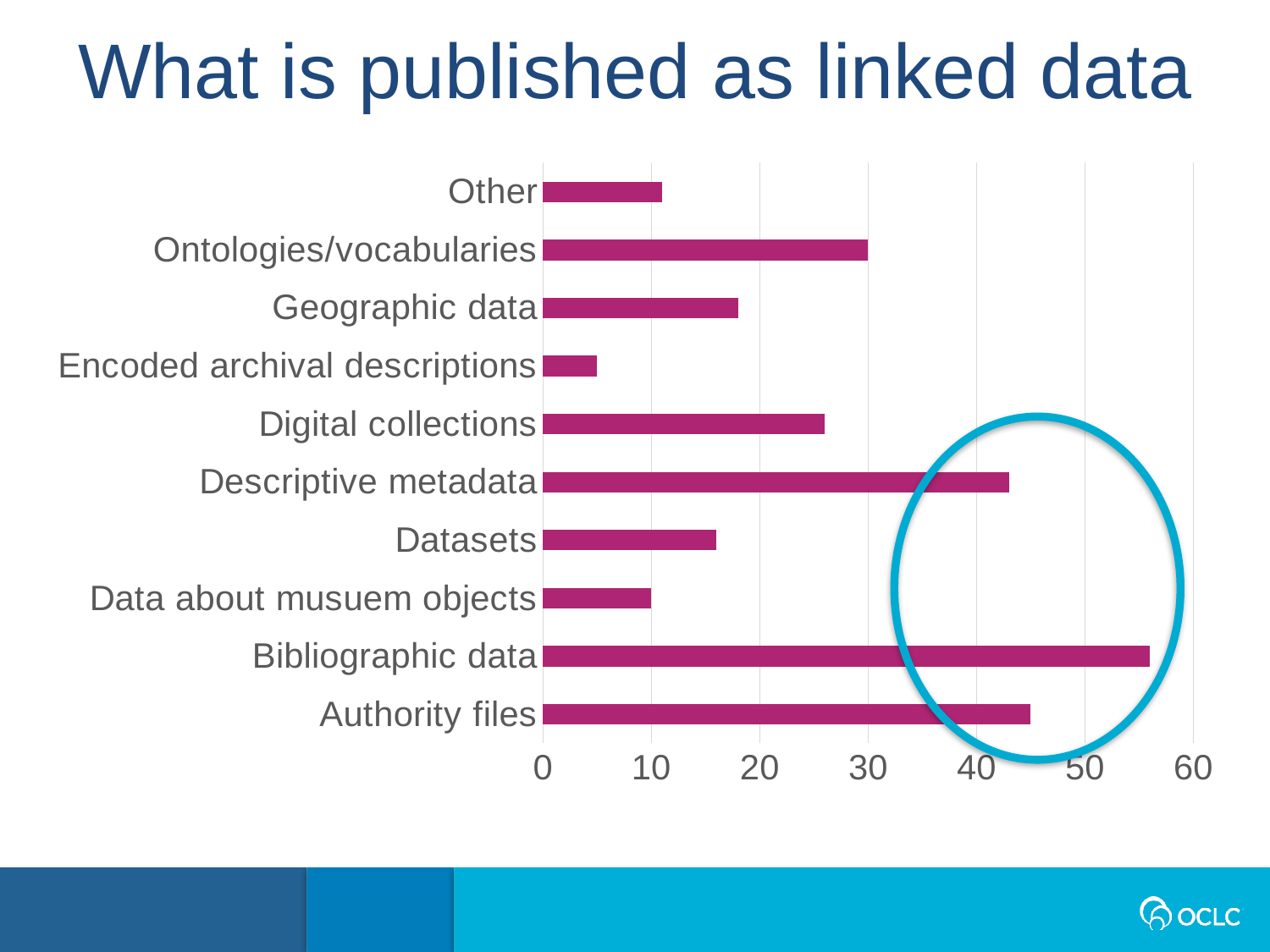
Is the value for Authority files greater or less than 50? less Is the value for Datasets greater or less than 20? less Is the value for Descriptive metadata greater or less than 40? greater Which is larger, the value for Digital collections or the value for Geographic data? Digital collections Which category has the highest value in the chart? Bibliographic data Which is larger, the value for Authority files or the value for Descriptive metadata? Authority files What kind of chart is shown on the slide? bar chart What is the title of the slide containing the chart? What is published as linked data How many categories are plotted in the chart? 10 Which category has the lowest value in the chart? Encoded archival descriptions